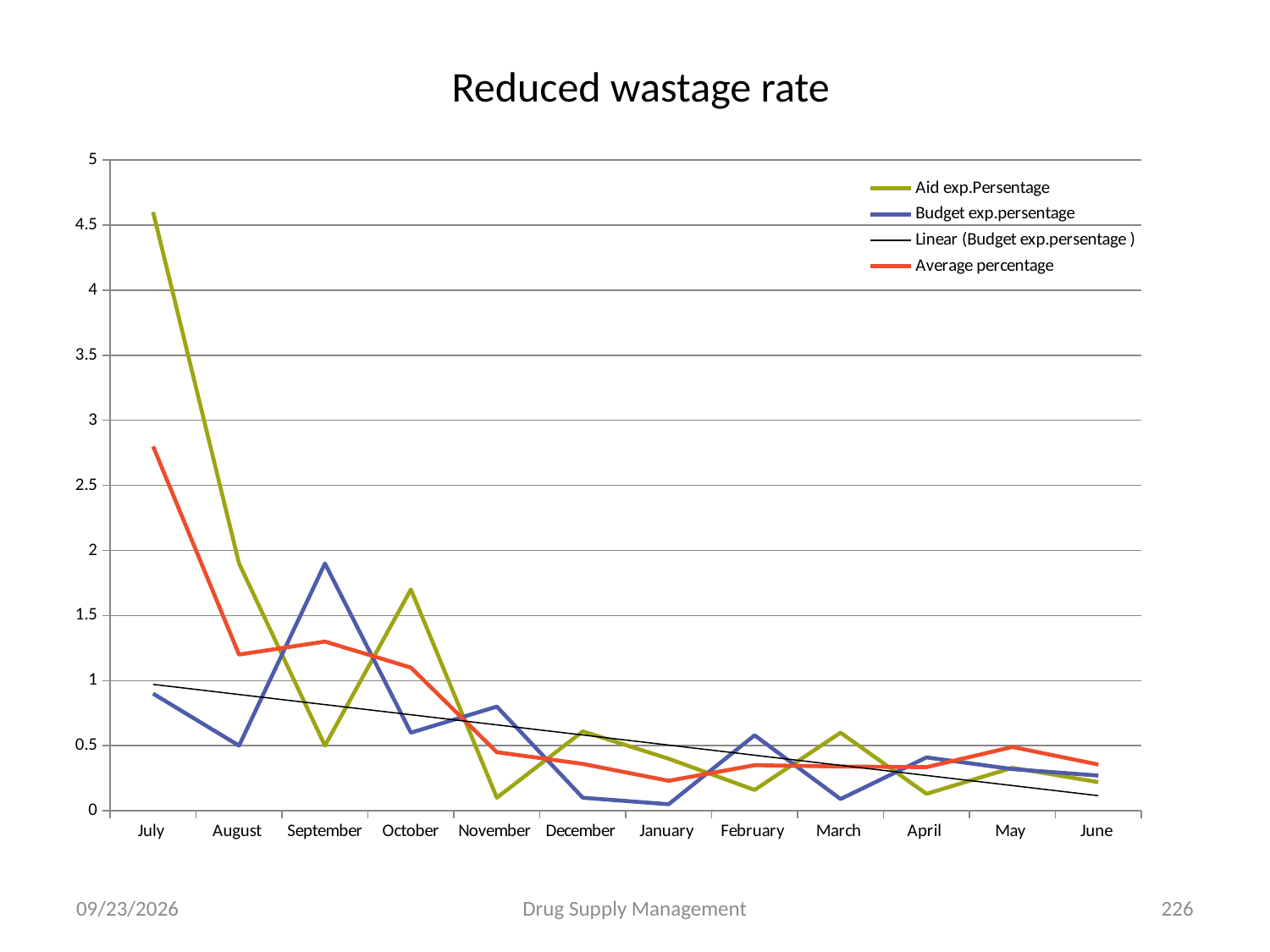
Does the Average percentage series generally rise or fall from July to June? fall In which month is the Budget exp.persentage series at its highest? September How many series does the legend list? 4 How many months are shown along the x axis? 12 In October, which is larger: Aid exp.Persentage or Budget exp.persentage? Aid exp.Persentage What is the title of the chart? Reduced wastage rate Is the value for Average percentage in July greater or less than 2.5? greater In which month is the Aid exp.Persentage series at its highest? July Is the value for Aid exp.Persentage in November greater or less than 0.5? less Is the value for Aid exp.Persentage in July greater or less than 4? greater What kind of chart is shown on the slide? line chart